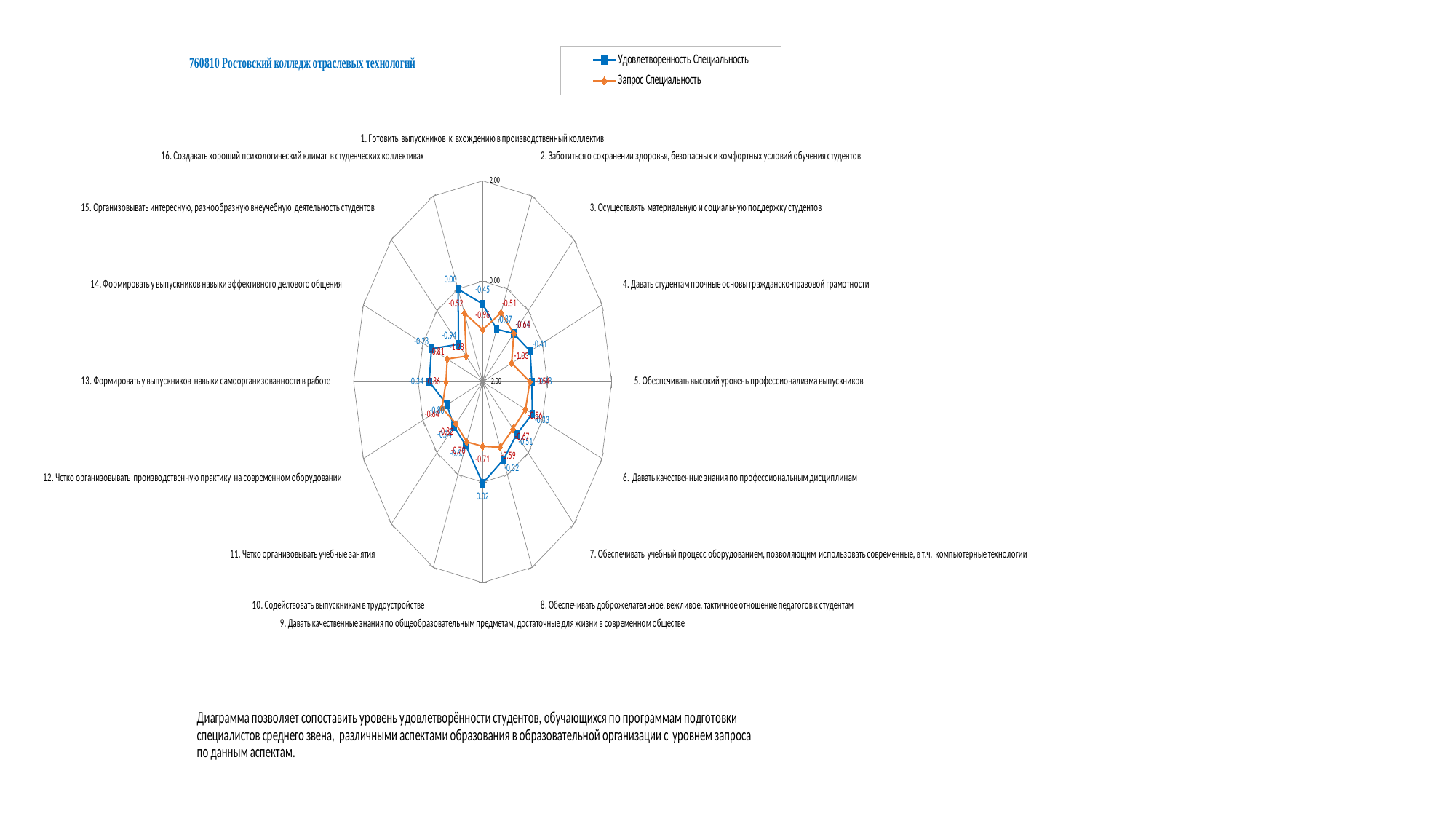
What is the maximum value shown on the radar chart's axis scale? 2.00 Which is larger for Удовлетворенность Специальность: category 11 or category 13? Category 13 What kind of chart is shown on the slide? Radar chart What is the title of the chart? 760810 Ростовский колледж отраслевых технологий Is the Удовлетворенность Специальность value for category 13 greater or less than 0.00? less Which category has the highest Удовлетворенность Специальность value? 9. Давать качественные знания по общеобразовательным предметам, достаточные для жизни в современном обществе What are the two series named in the legend? Удовлетворенность Специальность and Запрос Специальность What is the Удовлетворенность Специальность value for category 11 (Четко организовывать учебные занятия)? -0.74 What is the Удовлетворенность Специальность value for category 13 (Формировать у выпускников навыки самоорганизованности в работе)? -0.34 How many categories (aspects) are plotted on the radar chart? 16 How many series does the legend list? 2